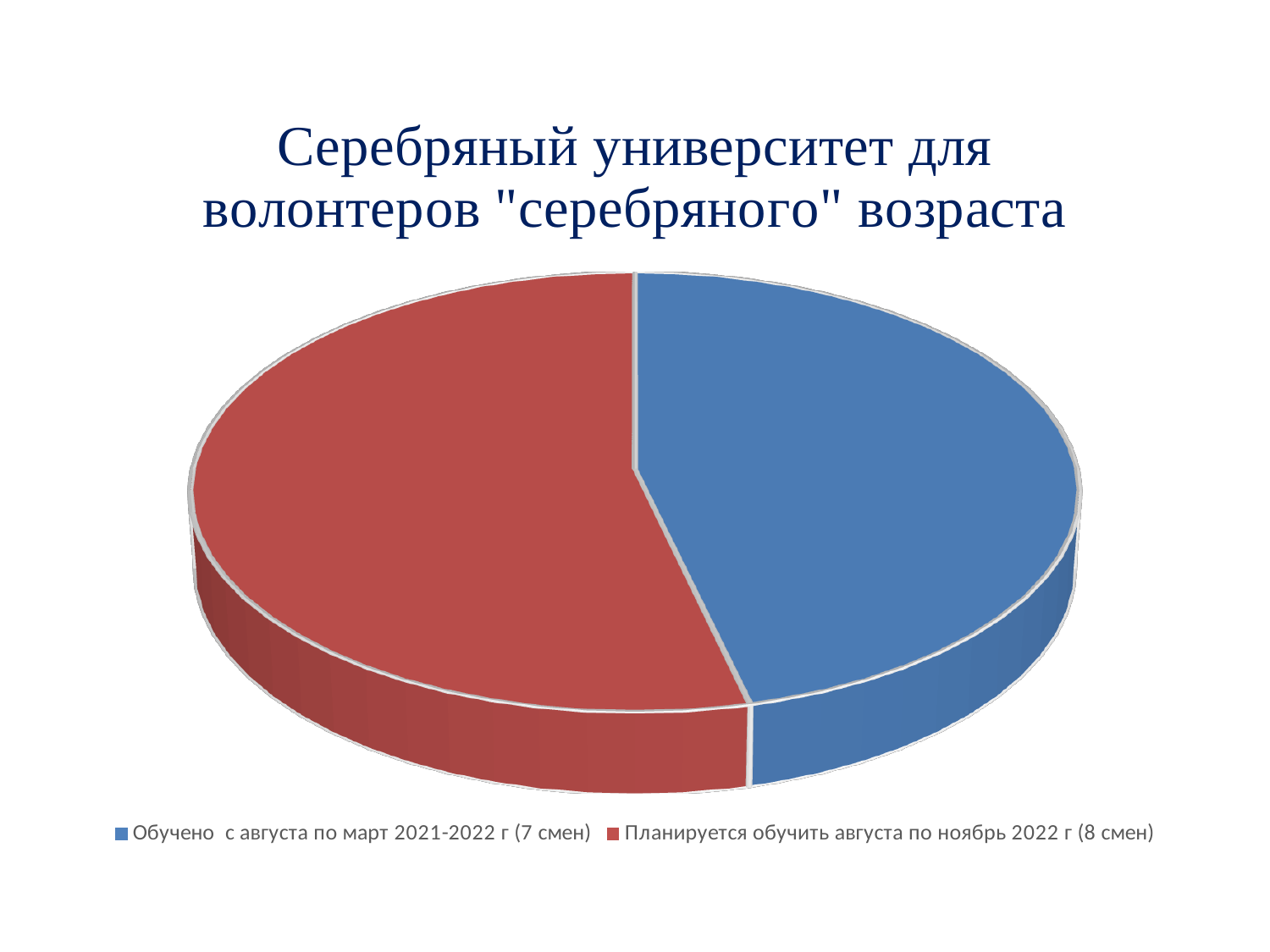
Which category has the smallest slice of the pie chart? Обучено с августа по март 2021-2022 г (7 смен) What colour is the slice for "Обучено с августа по март 2021-2022 г (7 смен)"? blue What kind of chart is shown on the slide? pie chart What is the title of the chart on the slide? Серебряный университет для волонтеров "серебряного" возраста How many entries does the legend of the pie chart list? 2 Which slice is larger: "Обучено с августа по март 2021-2022 г (7 смен)" or "Планируется обучить августа по ноябрь 2022 г (8 смен)"? Планируется обучить августа по ноябрь 2022 г (8 смен) How many slices does the pie chart have? 2 Which category has the largest slice of the pie chart? Планируется обучить августа по ноябрь 2022 г (8 смен)